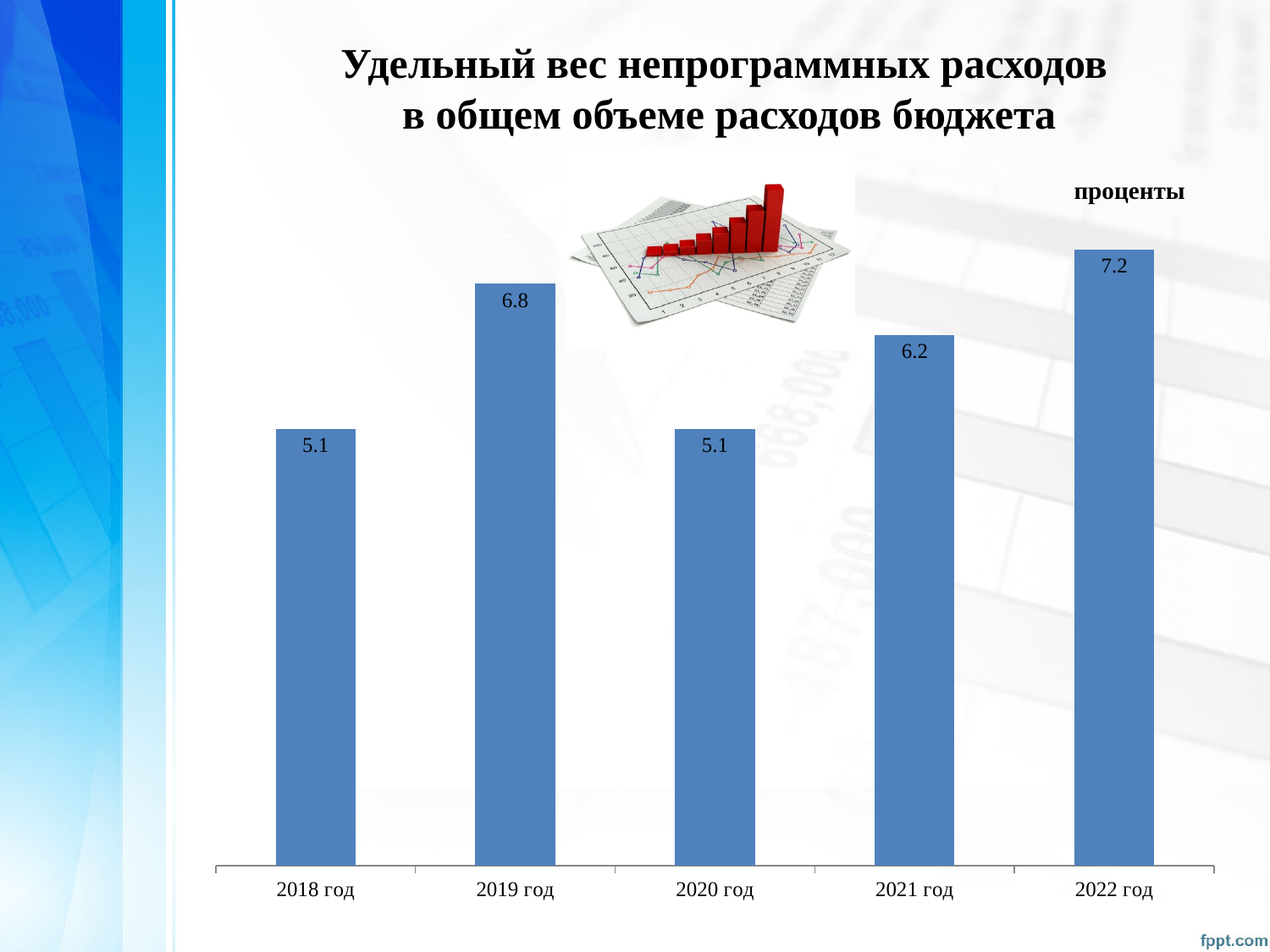
What is the difference between the values for 2022 год and 2021 год? 1.0 What unit label is shown at the top right of the chart? проценты How many years are shown on the chart? 5 What is the value for 2019 год? 6.8 Which is larger, the value for 2019 год or the value for 2021 год? 2019 год What is the value for 2021 год? 6.2 What is the value for 2018 год? 5.1 Which year has the highest value? 2022 год What is the value for 2022 год? 7.2 Which years share the lowest value? 2018 год and 2020 год What kind of chart is this? bar chart What is the difference between the values for 2019 год and 2018 год? 1.7